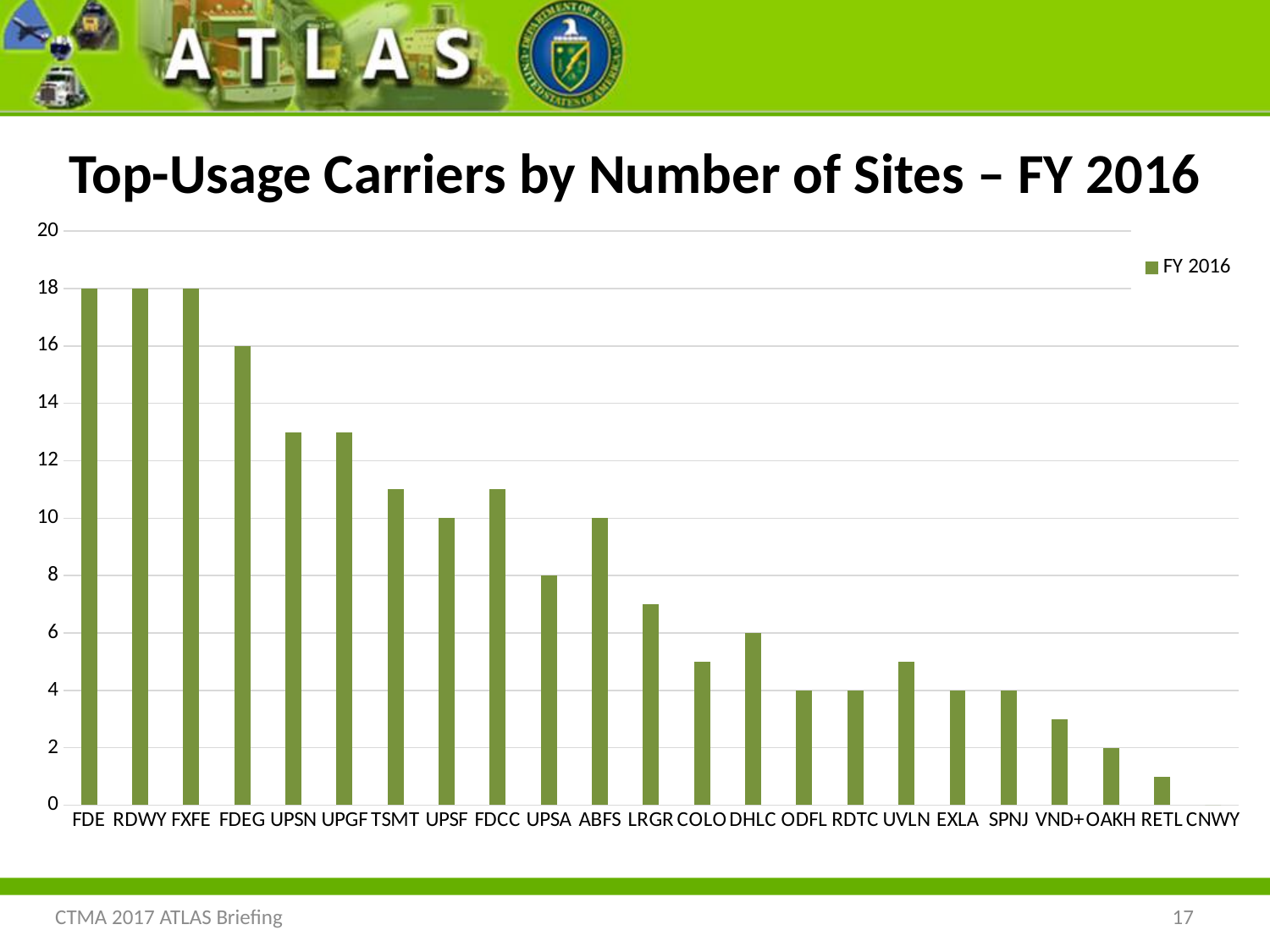
How many series does the legend list? 1 Is the value for UPSN greater or less than 12? greater What is the number of sites for OAKH? 2 Do the values generally rise or fall from left to right along the x axis? fall What is the number of sites for DHLC? 6 What type of chart is shown on the slide? bar chart Which has more sites, FDEG or UPSN? FDEG What is the difference in number of sites between FDEG and UPSF? 6 What is the number of sites for UPSF? 10 Is the value for LRGR greater or less than 8? less What is the number of sites for UPSA? 8 What is the number of sites for FDEG? 16